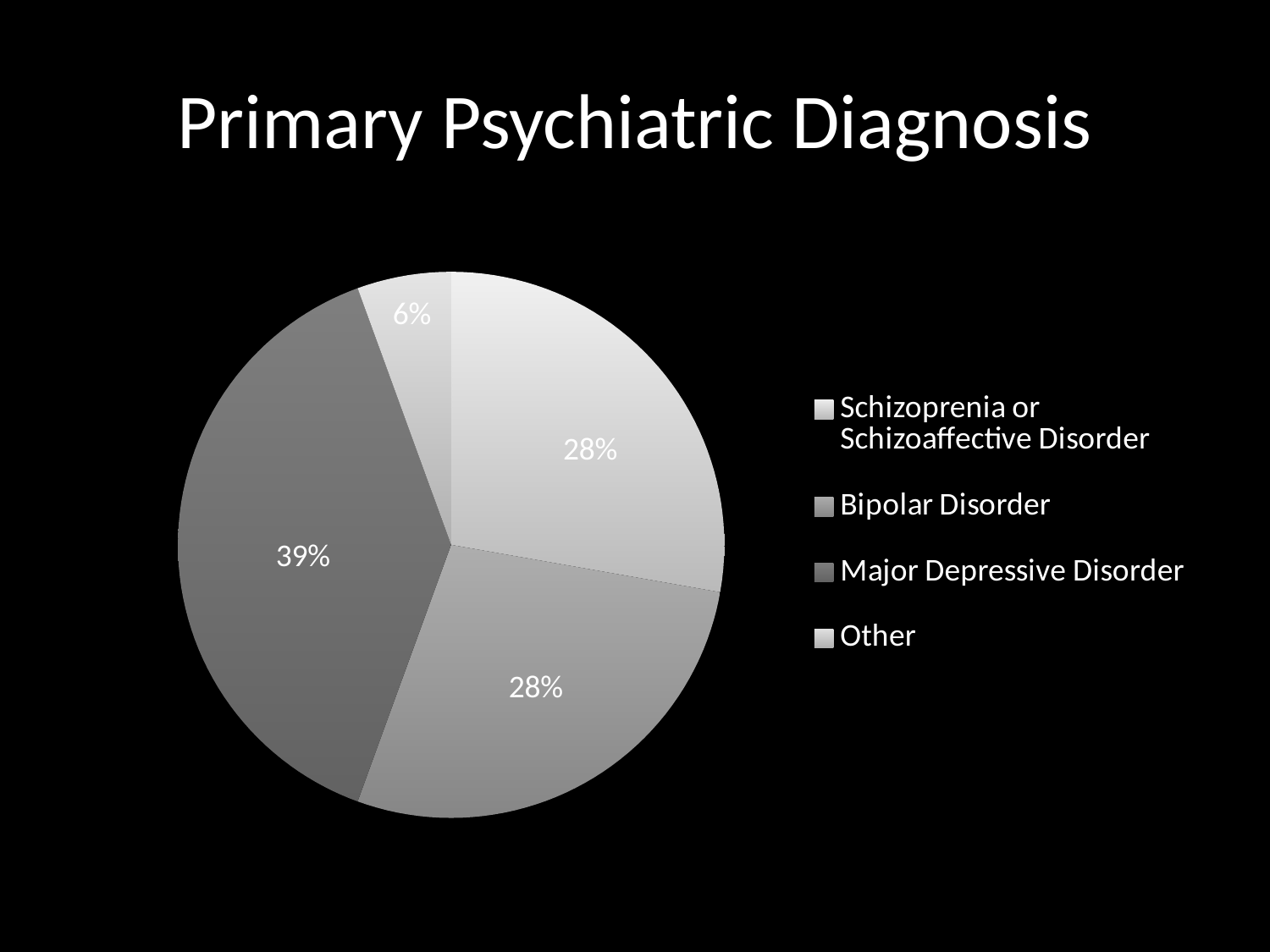
What is the title of the chart? Primary Psychiatric Diagnosis What share of the pie is Major Depressive Disorder? 39% Which is larger, the slice for Major Depressive Disorder or the slice for Other? Major Depressive Disorder Which category has the smallest slice of the pie? Other How many categories does the legend list? 4 What share of the pie is Schizoprenia or Schizoaffective Disorder? 28% What is the difference in percentage points between Major Depressive Disorder and Bipolar Disorder? 11 What kind of chart is shown on the slide? pie chart What share of the pie is Other? 6% Which category has the largest slice of the pie? Major Depressive Disorder What is the difference in percentage points between Schizoprenia or Schizoaffective Disorder and Other? 22